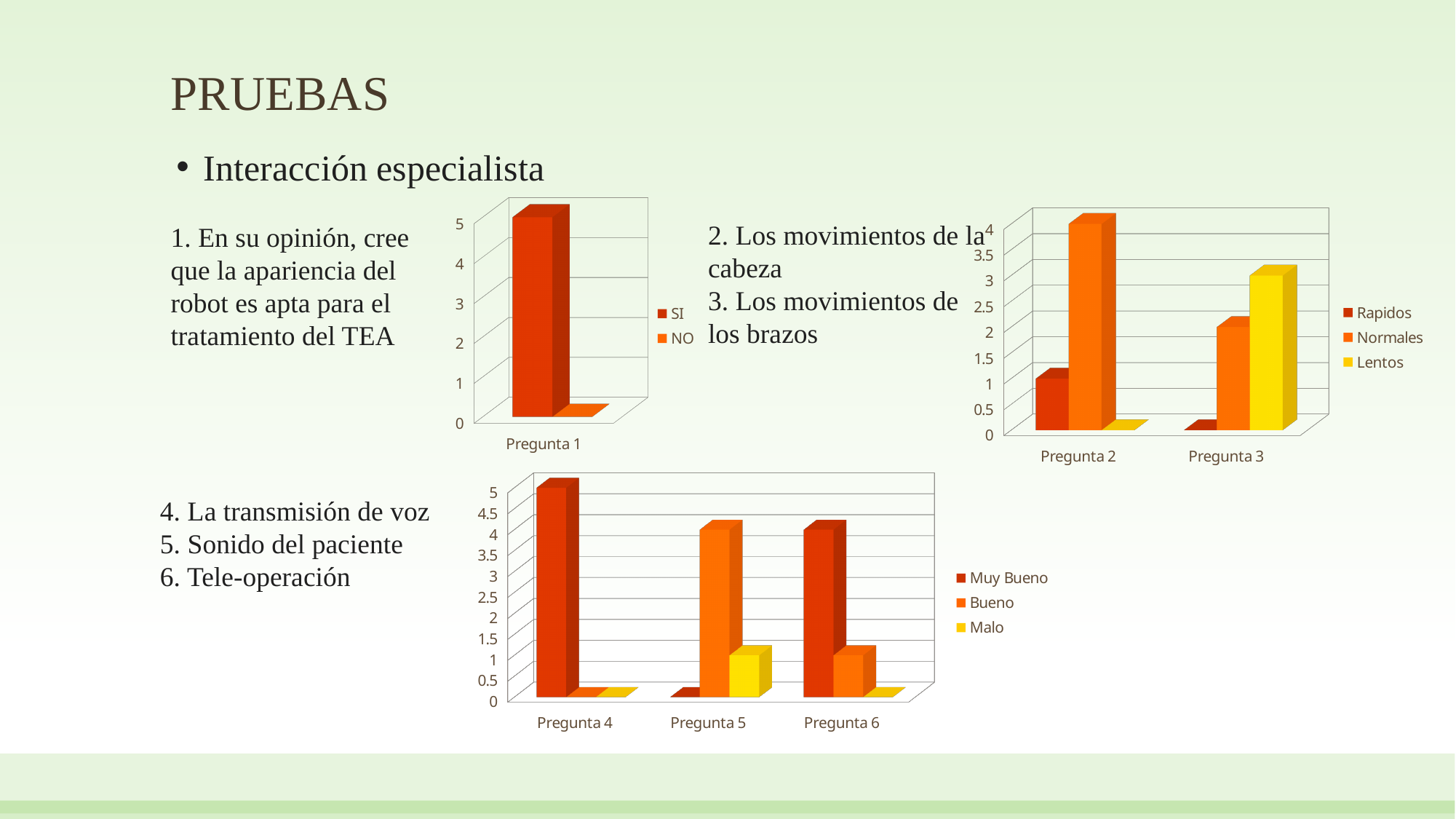
In the top-left chart, which series has the higher value for Pregunta 1, SI or NO? SI In the top-right chart, is the value for Normales in Pregunta 2 greater or less than 3? greater In the bottom chart, is the value for Muy Bueno in Pregunta 6 greater or less than 3? greater How many series does the legend of the top-left chart (Pregunta 1) list? 2 How many categories are shown on the x axis of the bottom chart? 3 What kind of chart is the top-left chart showing Pregunta 1? bar chart In the top-right chart, which series has the highest value for Pregunta 3? Lentos How many categories are shown on the x axis of the top-right chart? 2 In the bottom chart, which series has the highest value for Pregunta 5? Bueno What are the three legend entries of the top-right chart? Rapidos, Normales, Lentos In the top-left chart, is the value for SI in Pregunta 1 greater or less than 4? greater In the top-right chart, which series has the highest value for Pregunta 2? Normales